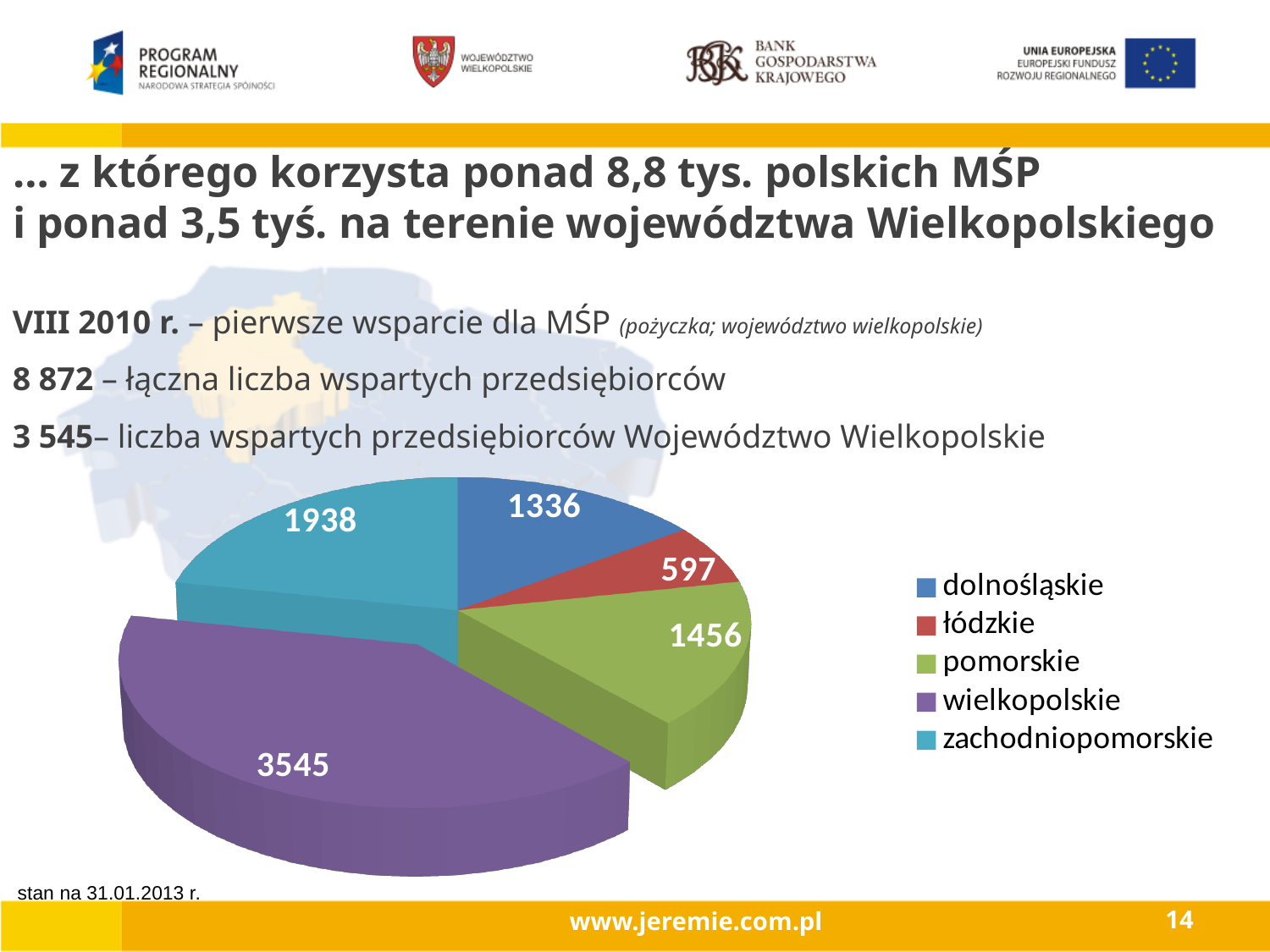
Which is larger, the value for pomorskie or the value for dolnośląskie? pomorskie What is the value for wielkopolskie in the pie chart? 3545 Which region has the smallest slice in the pie chart? łódzkie What is the value for zachodniopomorskie in the pie chart? 1938 What is the value for pomorskie in the pie chart? 1456 How many slices does the pie chart have? 5 What is the difference between the values for wielkopolskie and zachodniopomorskie? 1607 What colour is the wielkopolskie slice in the pie chart? purple What is the value for łódzkie in the pie chart? 597 Which region has the largest slice in the pie chart? wielkopolskie What type of chart is shown on the slide? pie chart What is the difference between the values for pomorskie and dolnośląskie? 120